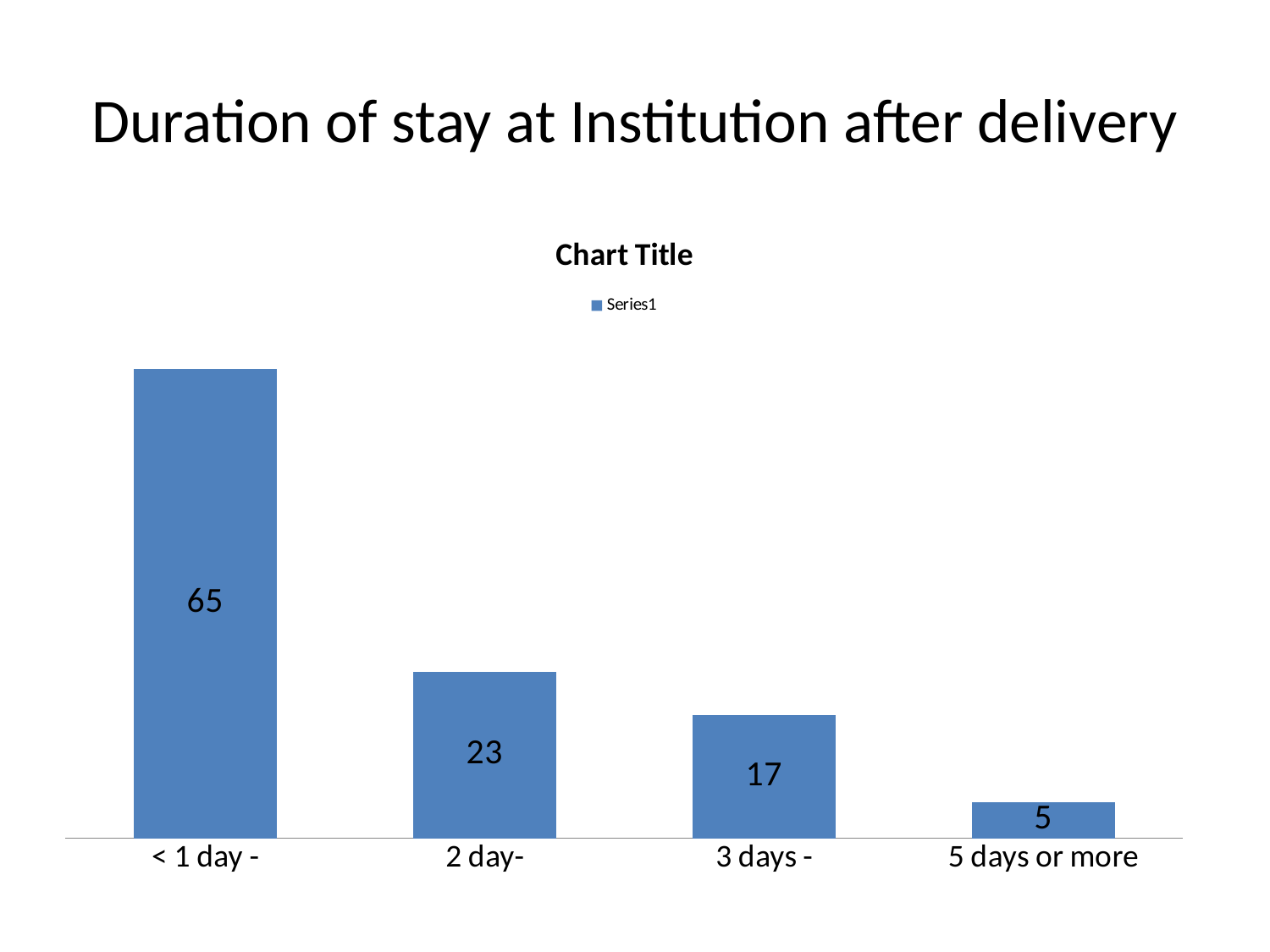
Which category has the lowest value? 5 days or more What is the difference between the values for '< 1 day -' and '2 day-'? 42 What is the value for the '3 days -' category? 17 What is the value for the '< 1 day -' category? 65 How many categories are shown on the x axis? 4 Which category has the highest value? < 1 day - Which is larger, the value for '2 day-' or the value for '3 days -'? 2 day- What kind of chart is shown on the slide? Bar chart What is the value for the '5 days or more' category? 5 Do the values rise or fall from left to right along the x axis? Fall What is the value for the '2 day-' category? 23 What is the difference between the values for '3 days -' and '5 days or more'? 12